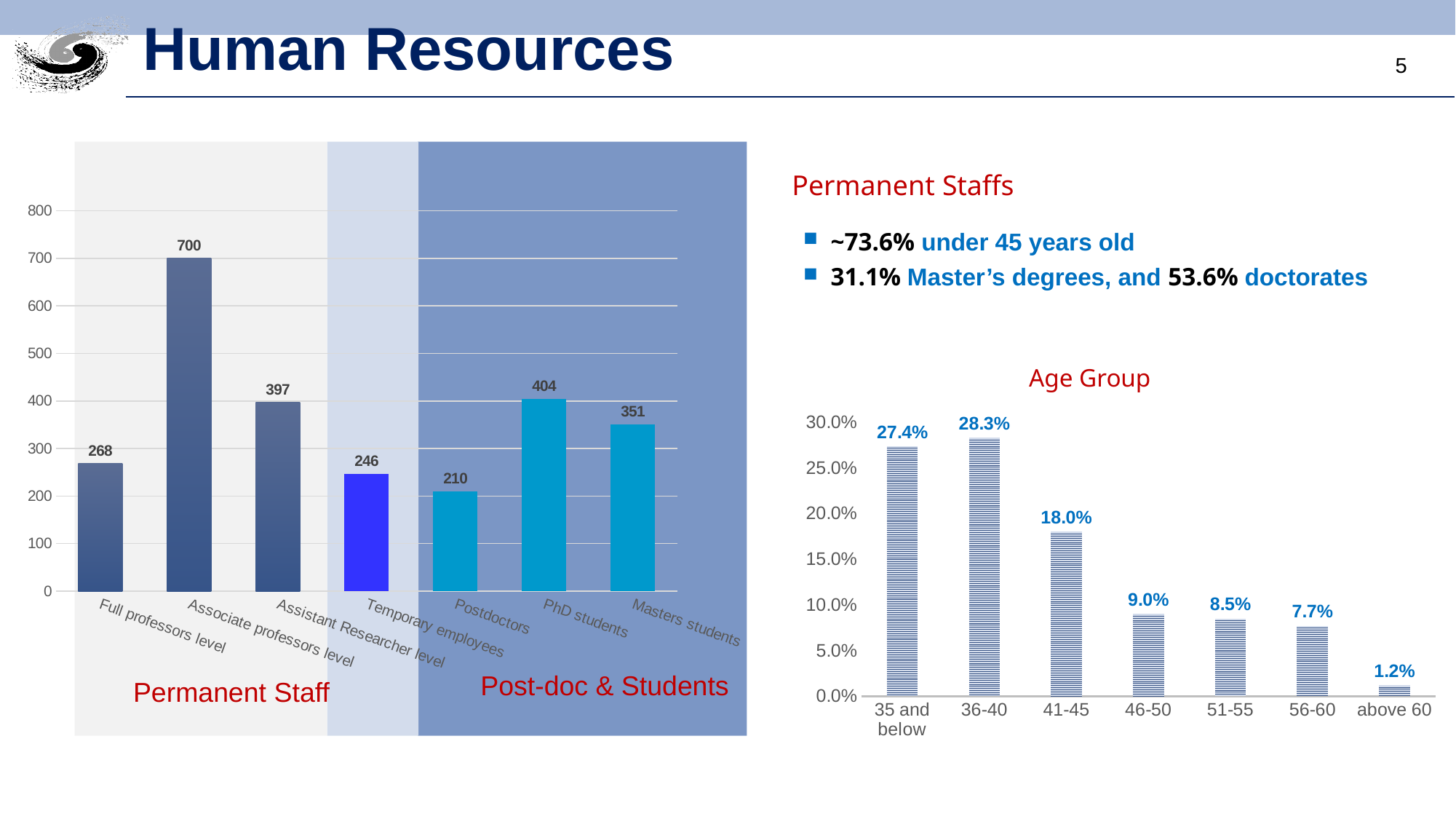
In the left-hand staff chart, what is the value for Temporary employees? 246 In the left-hand staff chart, what is the difference between PhD students and Masters students? 53 In the Age Group chart, what is the value for 41-45? 18.0% In the Age Group chart, do the values generally rise or fall from 36-40 to above 60? fall In the left-hand staff chart, what is the value for Associate professors level? 700 In the left-hand staff chart, which category has the highest value? Associate professors level In the left-hand staff chart, which is larger, Full professors level or Assistant Researcher level? Assistant Researcher level In the left-hand staff chart, which category has the lowest value? Postdoctors In the Age Group chart, which age group has the lowest share? above 60 What kind of chart is the Age Group chart? bar chart In the Age Group chart, which age group has the highest share? 36-40 How many categories are shown in the left-hand staff chart? 7